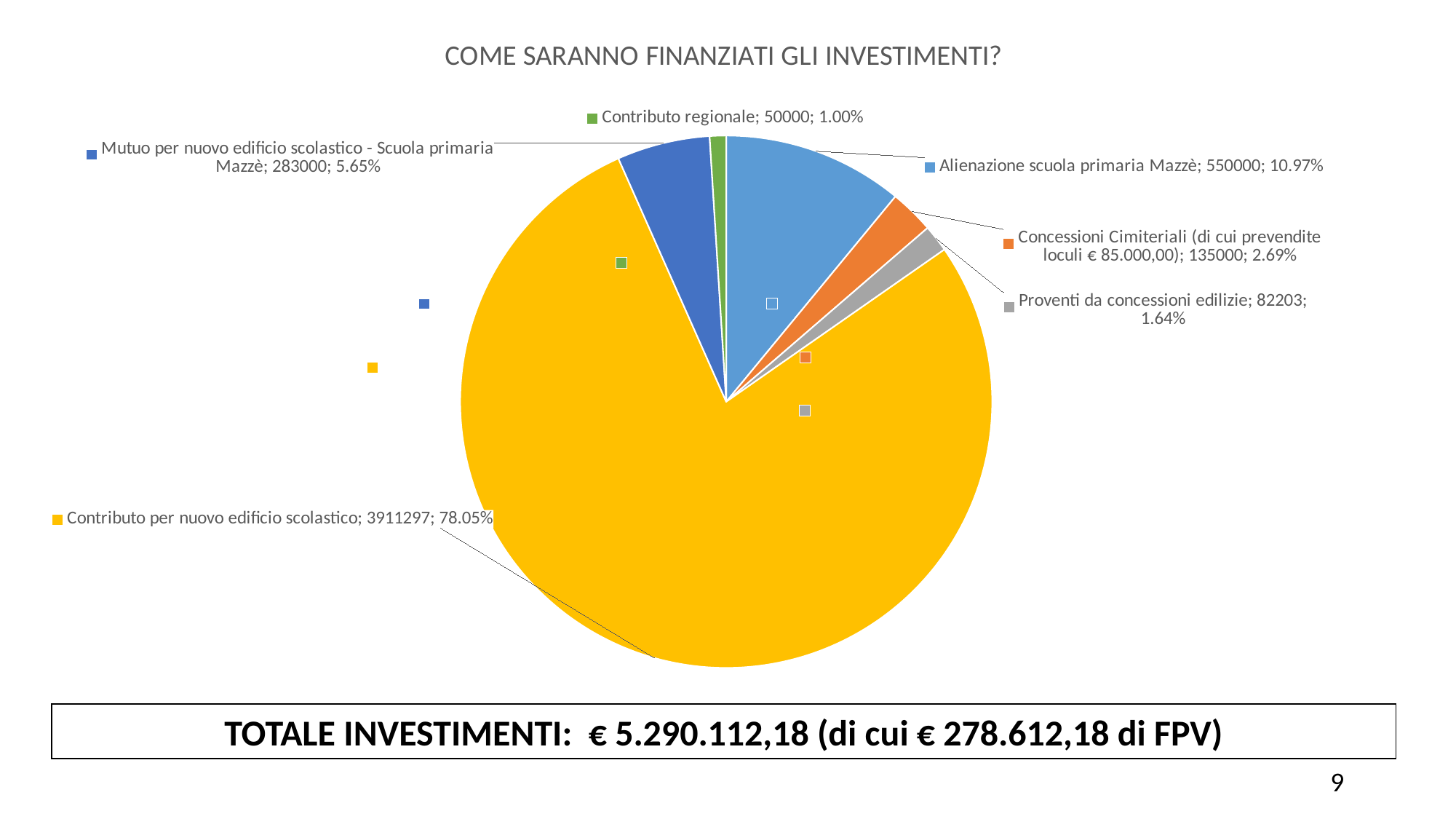
Which is larger, the value for Concessioni Cimiteriali or the value for Proventi da concessioni edilizie? Concessioni Cimiteriali What is the difference between the values for Alienazione scuola primaria Mazzè and Mutuo per nuovo edificio scolastico - Scuola primaria Mazzè? 267000 What share of the pie does Concessioni Cimiteriali represent? 2.69% What share of the pie does Contributo per nuovo edificio scolastico represent? 78.05% What is the title of the chart? COME SARANNO FINANZIATI GLI INVESTIMENTI? How many slices does the pie chart have? 6 What is the value for Contributo regionale? 50000 Which category has the smallest slice? Contributo regionale What type of chart is shown on the slide? pie chart What is the value for Alienazione scuola primaria Mazzè? 550000 Which category has the largest slice? Contributo per nuovo edificio scolastico What is the value for Proventi da concessioni edilizie? 82203